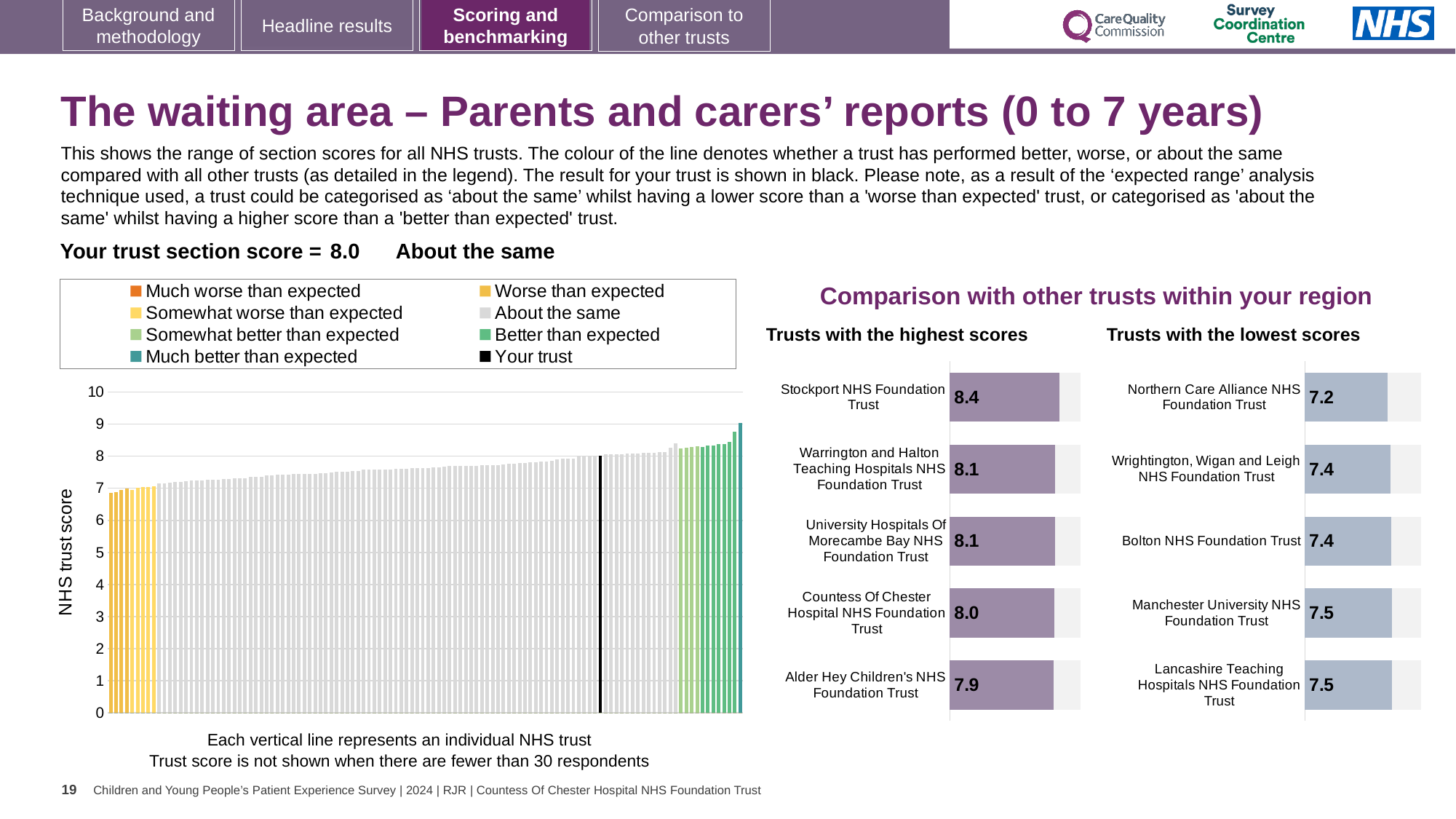
In the 'Trusts with the highest scores' chart, what is the difference between the scores of Stockport NHS Foundation Trust and Countess Of Chester Hospital NHS Foundation Trust? 0.4 In the 'Trusts with the highest scores' chart, what is the score for Stockport NHS Foundation Trust? 8.4 In the main chart on the left showing all NHS trusts, do the bar values rise or fall from left to right? Rise In the 'Trusts with the highest scores' chart, what is the score for Alder Hey Children's NHS Foundation Trust? 7.9 In the 'Trusts with the highest scores' chart, which trust has the highest score? Stockport NHS Foundation Trust In the main chart on the left showing all NHS trusts, how many entries does the legend list? 8 How many trusts are shown in the 'Trusts with the highest scores' chart? 5 In the 'Trusts with the lowest scores' chart, what is the score for Northern Care Alliance NHS Foundation Trust? 7.2 In the 'Trusts with the lowest scores' chart, what is the score for Manchester University NHS Foundation Trust? 7.5 In the 'Trusts with the lowest scores' chart, which trust has the lowest score? Northern Care Alliance NHS Foundation Trust What kind of chart is the main chart on the left showing all NHS trusts? Bar chart In the 'Trusts with the lowest scores' chart, which has the larger score: Bolton NHS Foundation Trust or Northern Care Alliance NHS Foundation Trust? Bolton NHS Foundation Trust